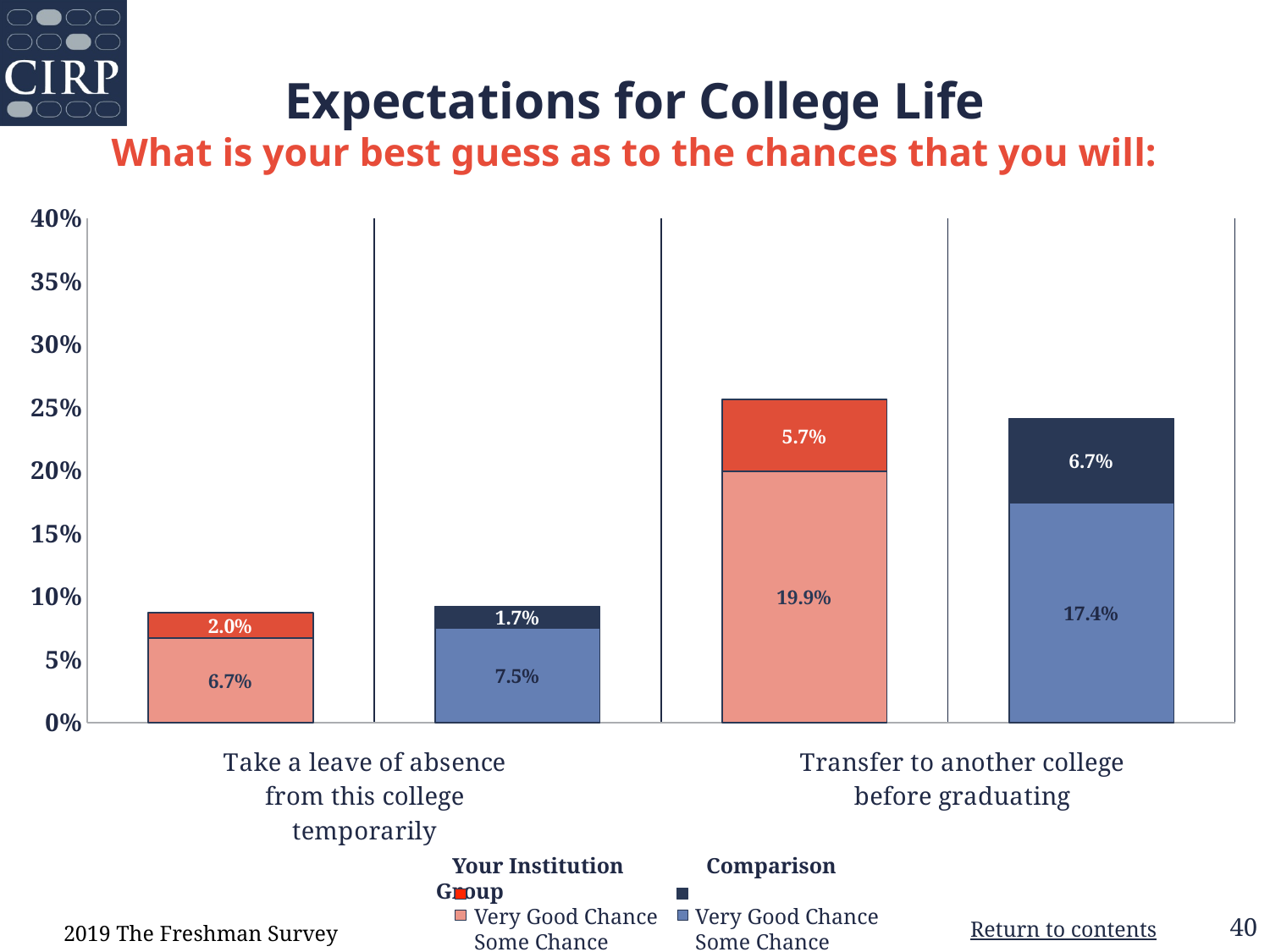
What is the total stacked value of the Comparison Group bar for 'Transfer to another college before graduating'? 24.1% For 'Transfer to another college before graduating', which group has the larger 'Very Good Chance' value, Your Institution or the Comparison Group? Comparison Group How many series does the legend list? 4 How many categories are shown on the x axis of the chart? 2 Is the total of the Your Institution bar for 'Transfer to another college before graduating' greater or less than 25%? greater What is the 'Very Good Chance' value for the Comparison Group for 'Take a leave of absence from this college temporarily'? 1.7% What is the total stacked value of the Your Institution bar for 'Take a leave of absence from this college temporarily'? 8.7% What kind of chart is shown on the slide? Stacked bar chart What is the difference between the 'Some Chance' values for Your Institution and the Comparison Group for 'Transfer to another college before graduating'? 2.5% What is the 'Some Chance' value for Your Institution for 'Transfer to another college before graduating'? 19.9% What is the 'Very Good Chance' value for Your Institution for 'Transfer to another college before graduating'? 5.7% What is the 'Some Chance' value for the Comparison Group for 'Take a leave of absence from this college temporarily'? 7.5%